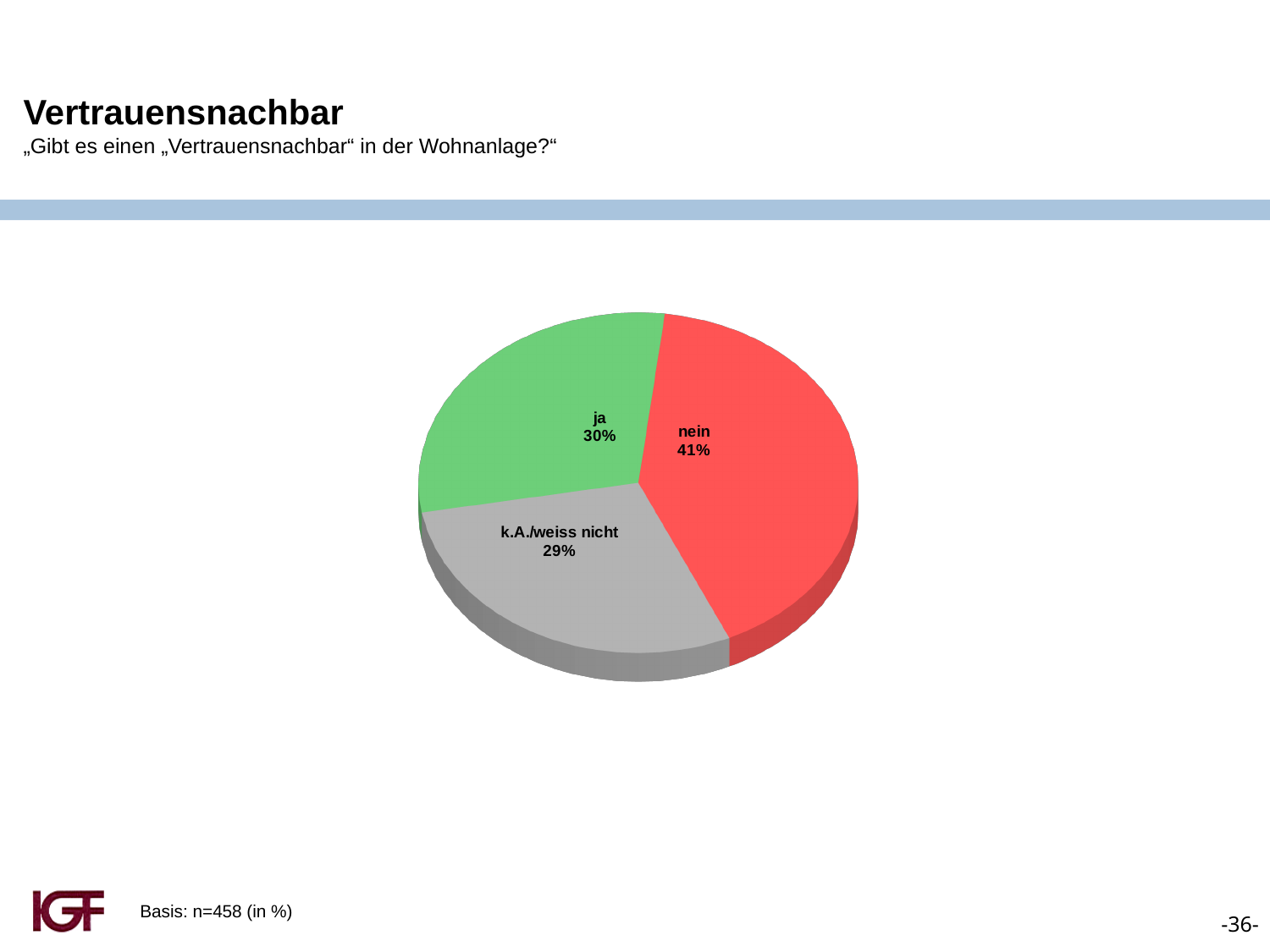
What colour is the "nein" slice? red What kind of chart is shown on the slide? pie chart How many slices does the pie chart have? 3 What is the difference in percentage points between the "nein" and "ja" slices? 11 Which is larger, the "nein" slice or the "ja" slice? nein What is the sample size (Basis) stated on the slide? n=458 What share of the pie does "nein" represent? 41% What share of the pie does "ja" represent? 30% Which slice of the pie is the largest? nein What share of the pie does "k.A./weiss nicht" represent? 29% Which slice of the pie is the smallest? k.A./weiss nicht What is the difference in percentage points between the "ja" and "k.A./weiss nicht" slices? 1